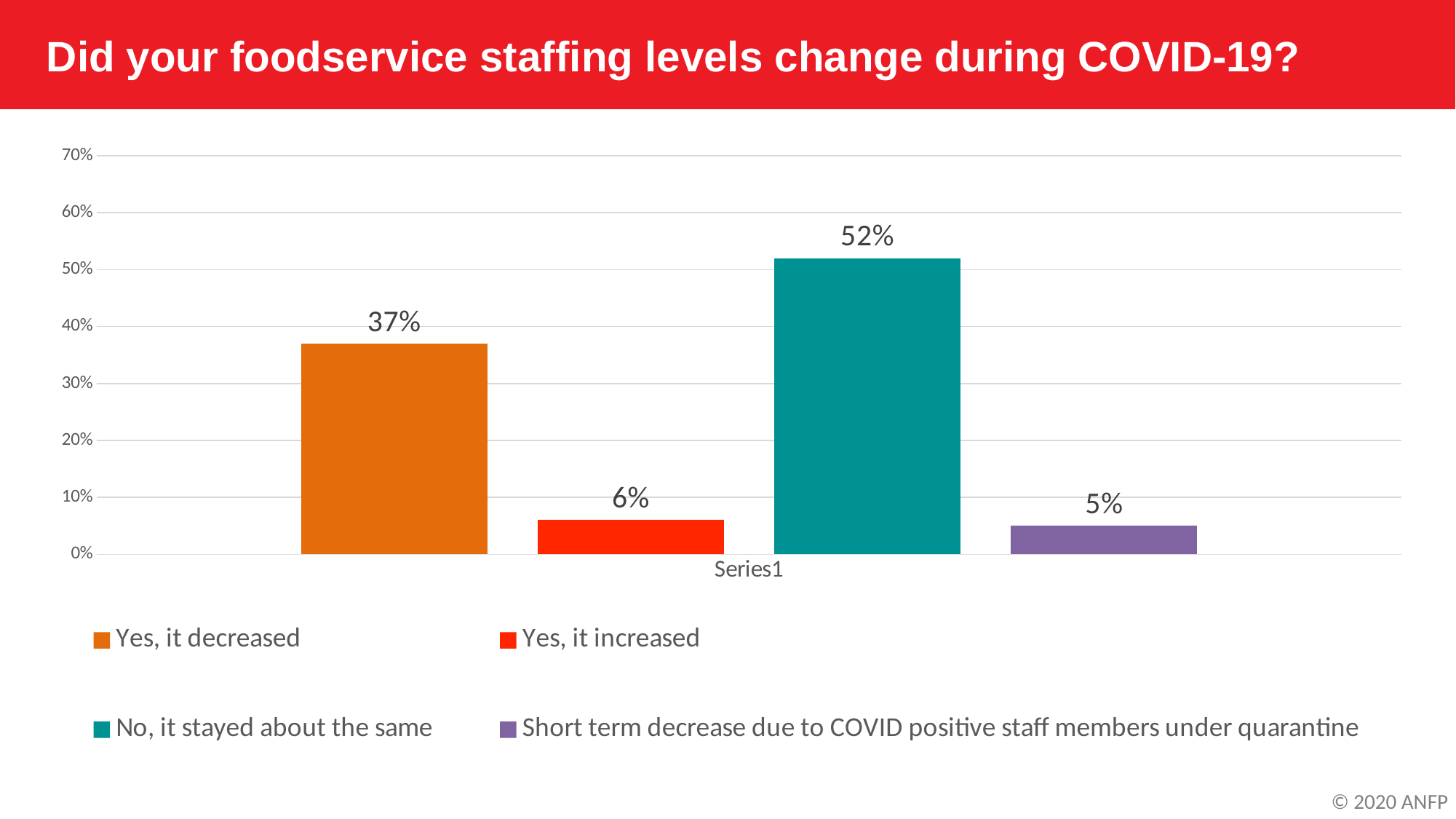
What percentage reported a short term decrease due to COVID positive staff members under quarantine? 5% What type of chart is shown on the slide? Bar chart Which response has the lowest percentage? Short term decrease due to COVID positive staff members under quarantine What percentage of respondents said their foodservice staffing levels increased? 6% What colour is the bar for 'No, it stayed about the same'? Teal What percentage of respondents said their foodservice staffing levels decreased? 37% What percentage of respondents said staffing stayed about the same? 52% Is the value for 'Yes, it decreased' greater or less than 40%? less How many bars are shown in the chart? 4 Which response has the highest percentage? No, it stayed about the same What is the difference in percentage points between 'No, it stayed about the same' and 'Yes, it decreased'? 15 Which is larger: the percentage for 'Yes, it decreased' or 'Yes, it increased'? Yes, it decreased